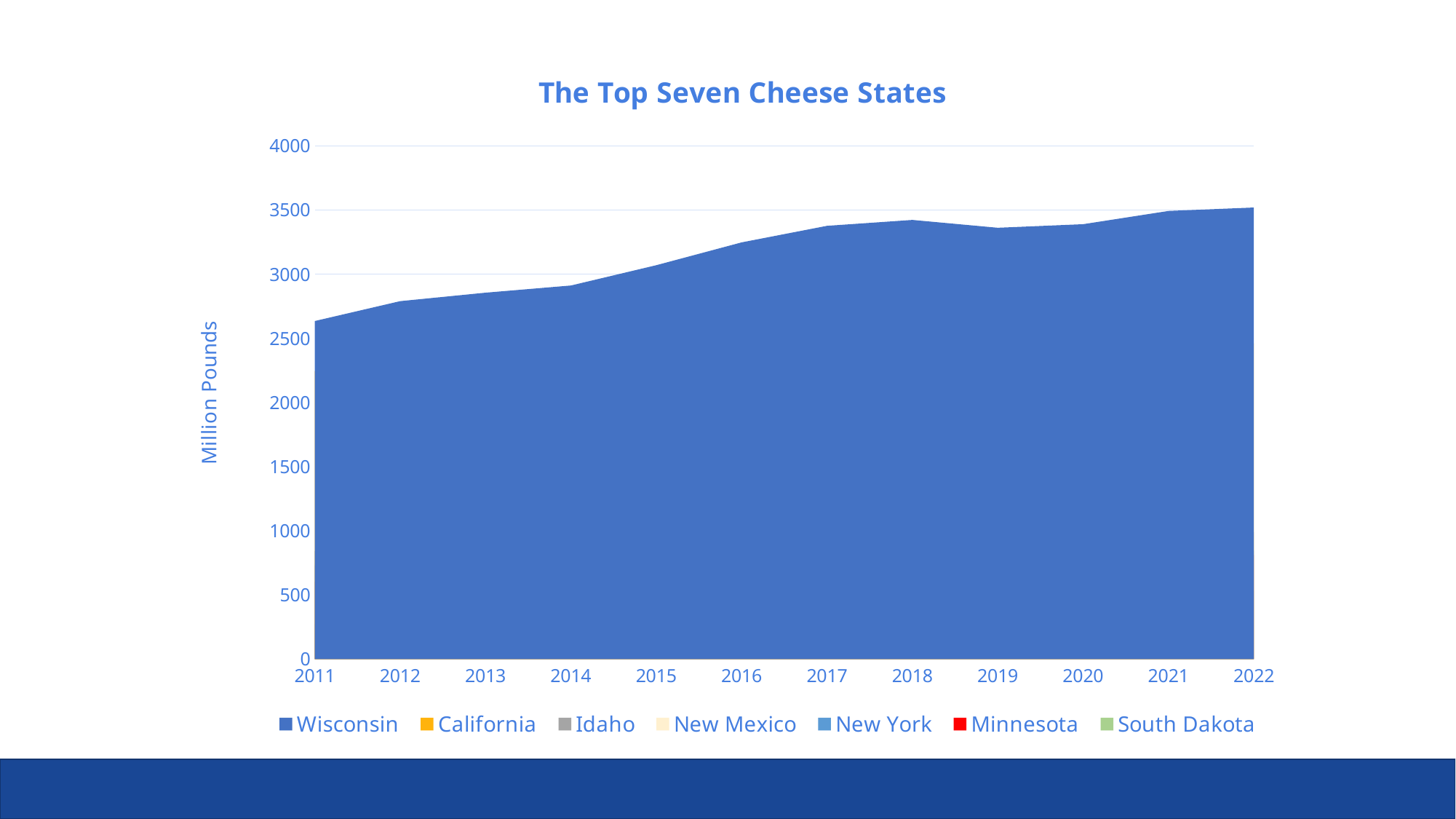
What kind of chart is shown on the slide? Area chart In which year is the plotted value lowest? 2011 Do the plotted values generally rise or fall from 2011 to 2022? Rise What is the title of the chart? The Top Seven Cheese States What is the label of the vertical axis? Million Pounds Which is larger, the value for 2011 or the value for 2022? 2022 In which year is the plotted value highest? 2022 Is the value for 2017 greater or less than 3000? greater How many years are shown along the x axis? 12 Is the value for 2011 greater or less than 2500? greater Is the value for 2011 greater or less than 3000? less How many series does the legend list? 7